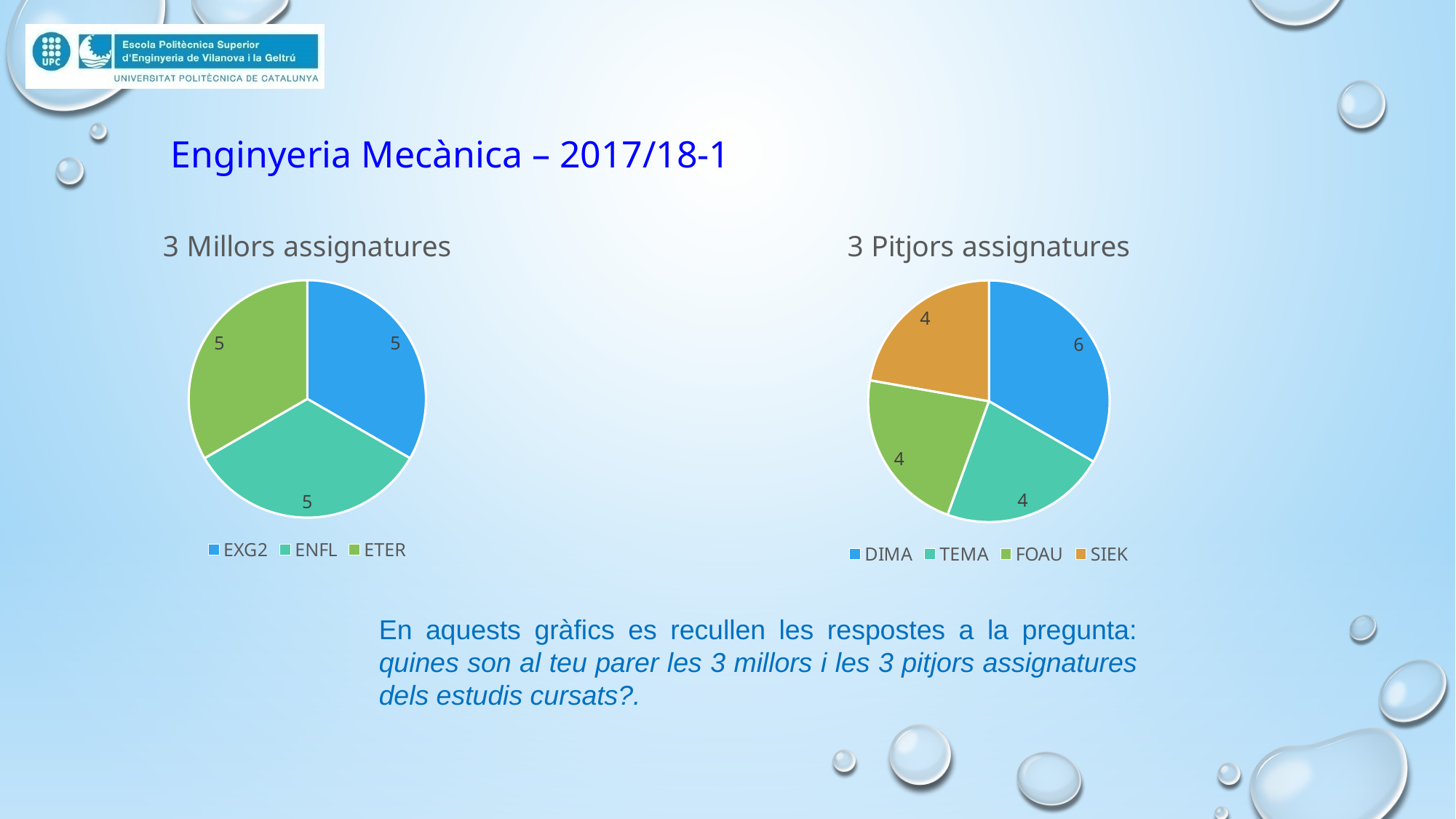
How many categories does the legend of the "3 Pitjors assignatures" chart list? 4 In the "3 Pitjors assignatures" chart, what is the difference between the values for DIMA and TEMA? 2 In the "3 Millors assignatures" chart, what is the value for ETER? 5 In the "3 Pitjors assignatures" chart, which is larger, the value for DIMA or the value for FOAU? DIMA In the "3 Pitjors assignatures" chart, which category has the largest slice? DIMA How many slices does the "3 Millors assignatures" pie chart have? 3 In the "3 Pitjors assignatures" chart, what share of the pie does DIMA represent? one third What kind of chart is the "3 Millors assignatures" chart? pie chart In the "3 Millors assignatures" chart, what is the value for ENFL? 5 In the "3 Pitjors assignatures" chart, what is the value for SIEK? 4 Which legend entry in the "3 Pitjors assignatures" chart is shown in orange? SIEK In the "3 Pitjors assignatures" chart, what is the value for DIMA? 6